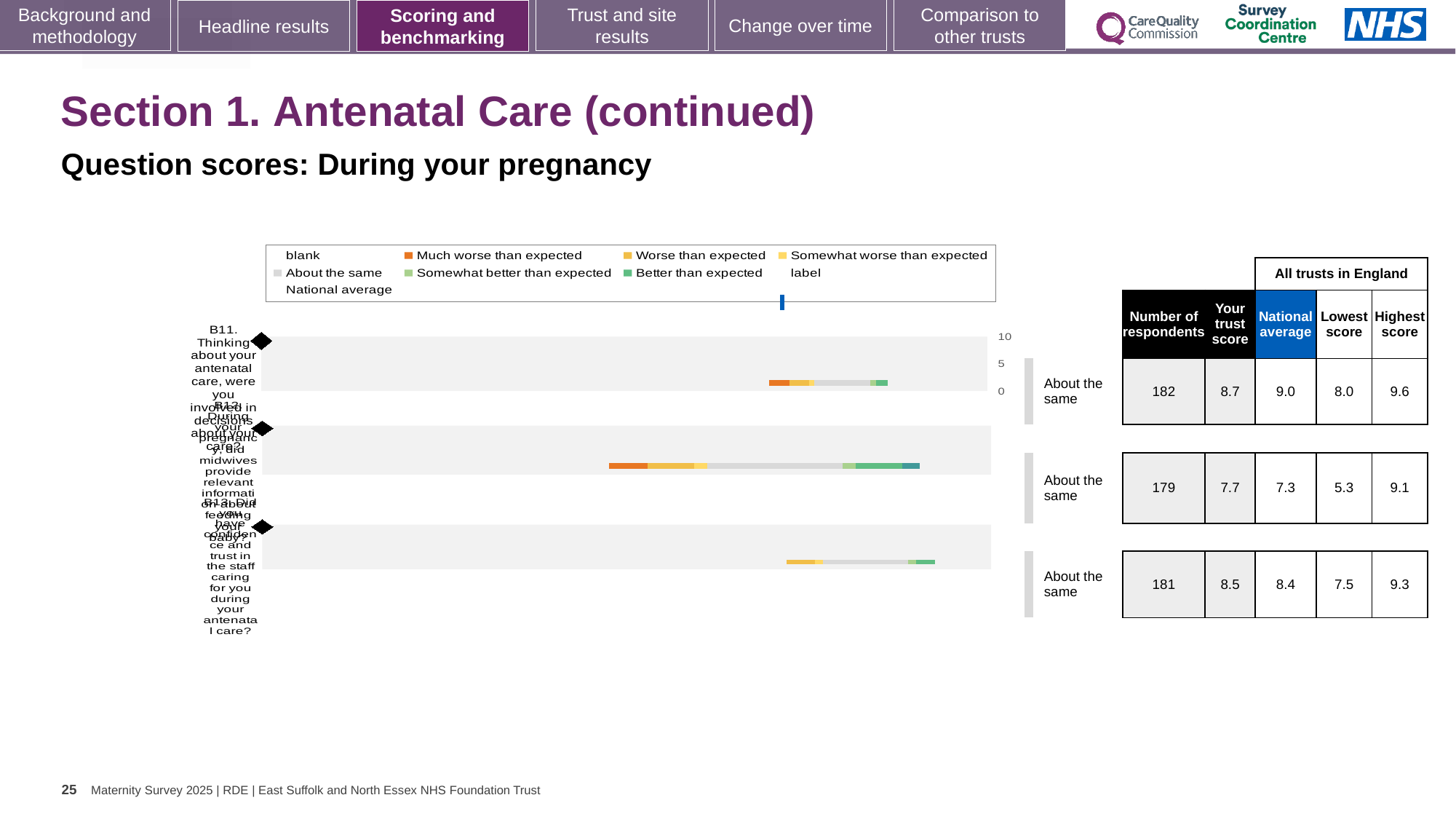
Which question has the lowest 'Lowest score' among all trusts in England? B12 What is the national average for question B12 (midwives provide relevant information about feeding your baby)? 7.3 What is the difference between the highest score and the lowest score for question B11? 1.6 What is the highest score across all trusts in England for question B13? 9.3 For question B12, which is larger: the trust score or the national average? Trust score (7.7) Which question has the highest 'Your trust score'? B11 How many questions (bars) are plotted in the chart? 3 What benchmark category is shown for question B13? About the same What is the 'Your trust score' for question B11 (involved in decisions about your care)? 8.7 What kind of chart is used to show the question scores on this slide? Bar chart How many respondents are listed for question B13 (confidence and trust in staff during antenatal care)? 181 What colour does the legend use for 'Much worse than expected'? Orange